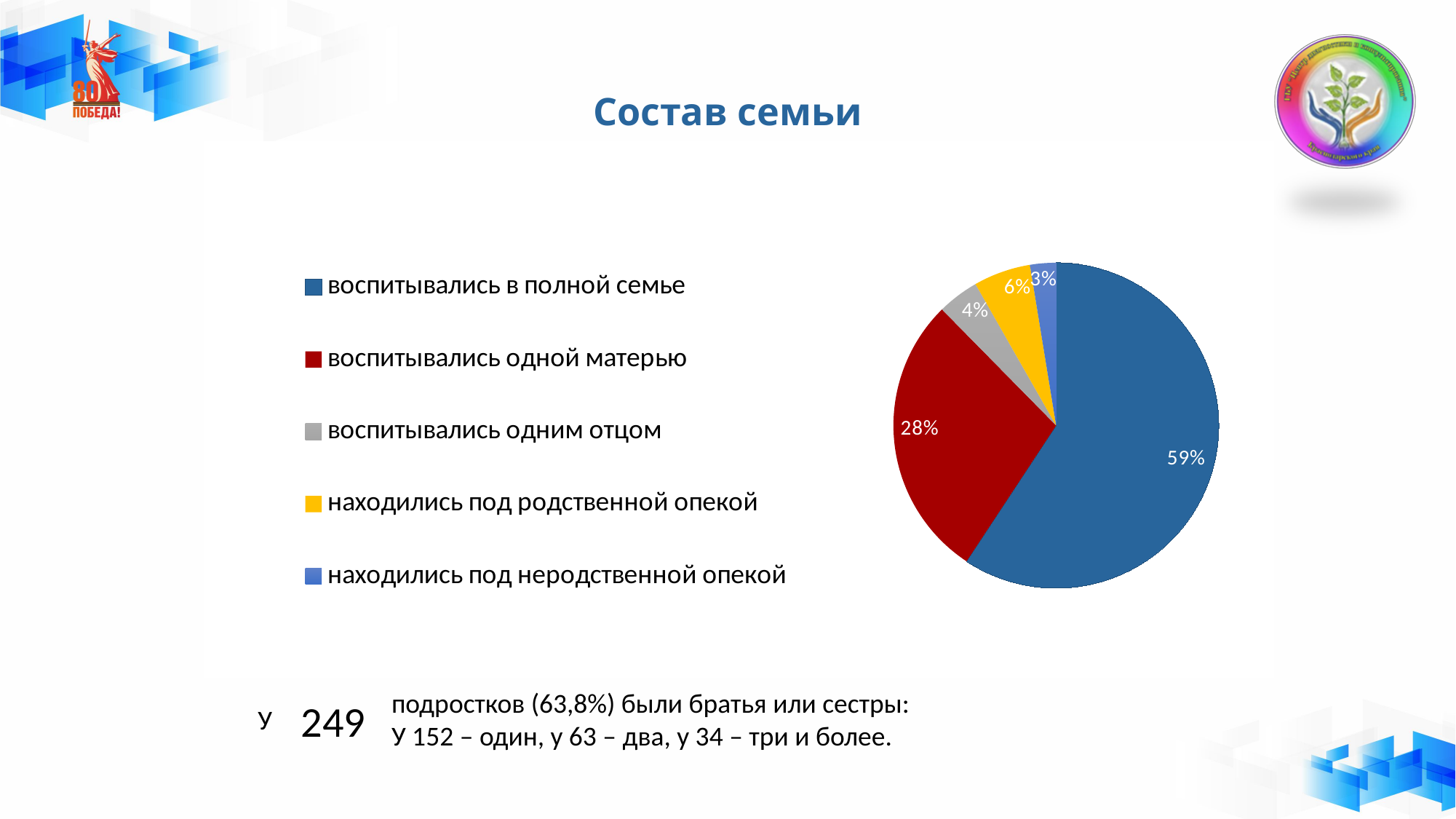
Which category has the largest slice of the pie? воспитывались в полной семье What share of the pie is labelled 'находились под неродственной опекой'? 3% Which is larger: the slice for 'находились под родственной опекой' or the slice for 'воспитывались одним отцом'? находились под родственной опекой How many categories does the legend list? 5 What is the difference in percentage points between 'воспитывались в полной семье' and 'воспитывались одной матерью'? 31 What share of the pie is labelled 'воспитывались в полной семье'? 59% What kind of chart is shown on the slide? pie chart Which category has the smallest slice of the pie? находились под неродственной опекой What is the title of the chart? Состав семьи What share of the pie is labelled 'находились под родственной опекой'? 6% What share of the pie is labelled 'воспитывались одним отцом'? 4% What share of the pie is labelled 'воспитывались одной матерью'? 28%